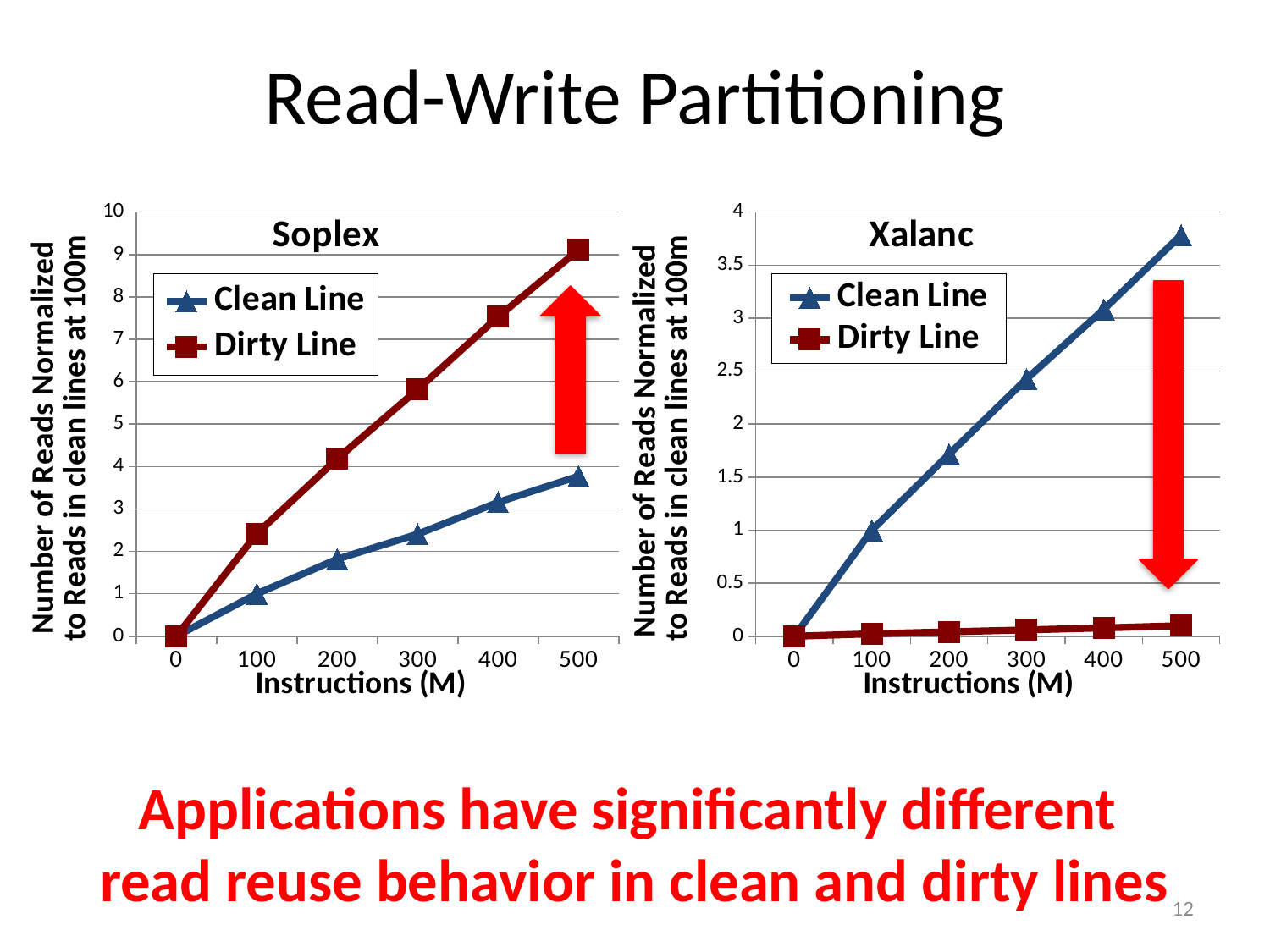
In the Xalanc chart, is the Clean Line value at 500 instructions greater or less than 3.5? greater In the Xalanc chart, is the Dirty Line value at 500 instructions greater or less than 0.5? less How many series does the legend of the Xalanc chart list? 2 What kind of chart is the Soplex chart? line chart What is the title of the chart on the right side of the slide? Xalanc In the Soplex chart, which series is higher at 300 instructions, Clean Line or Dirty Line? Dirty Line How many data points does each series in the Soplex chart have? 6 In the Xalanc chart, which series is higher at 400 instructions, Clean Line or Dirty Line? Clean Line In the Xalanc chart, does the Clean Line rise or fall as instructions increase from 0 to 500? rise In the Soplex chart, is the Clean Line value at 500 instructions greater or less than 4? less What is the x-axis label of the Soplex chart? Instructions (M)